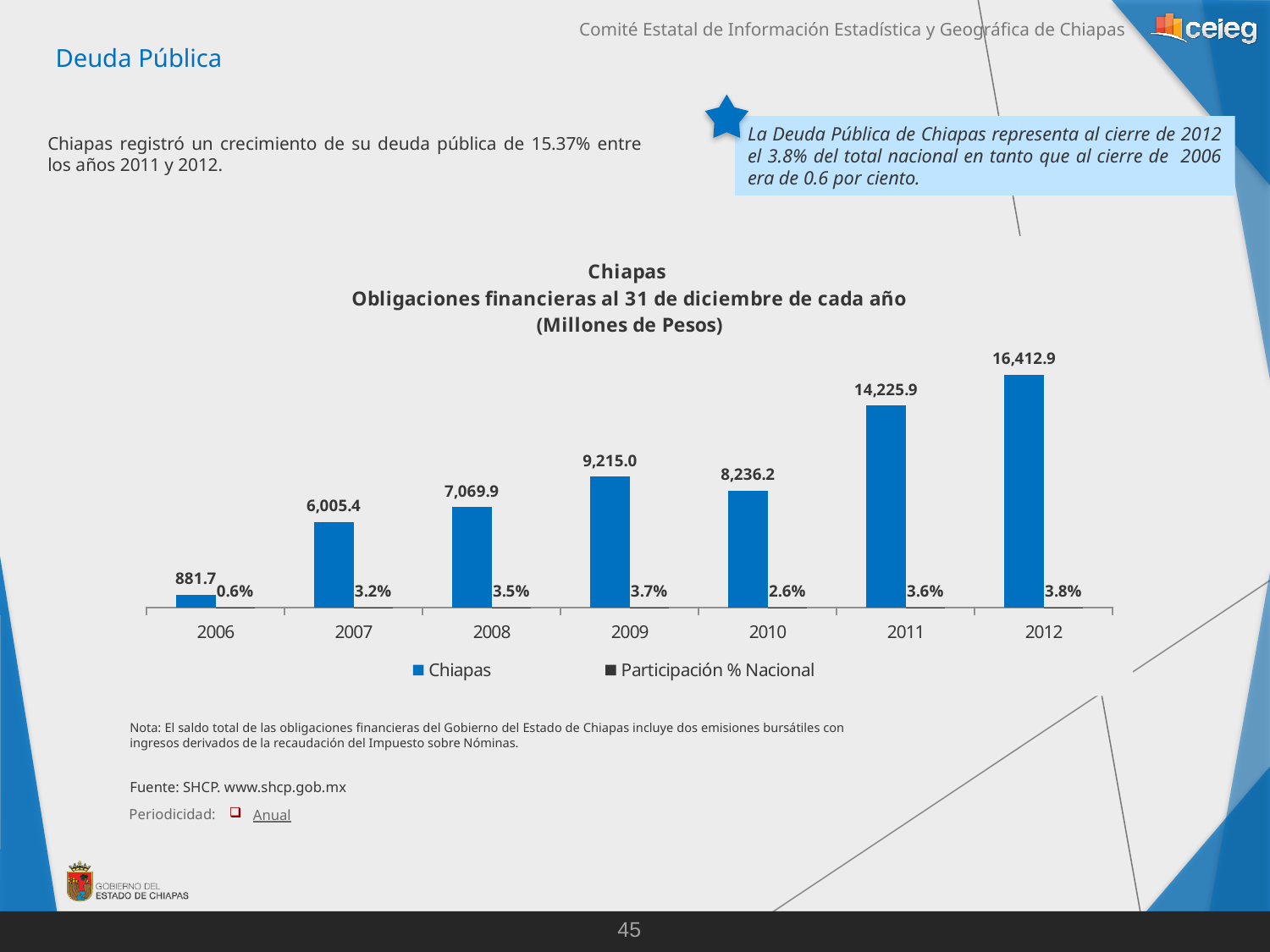
What unit is given in the chart title for the Chiapas values? Millones de Pesos Which year has the highest Chiapas value? 2012 What is the Chiapas value for 2012? 16,412.9 How many years are shown on the x axis? 7 What is the difference between the Chiapas values for 2012 and 2011? 2,187.0 What is the Participación % Nacional value for 2009? 3.7% Which year has the lowest Participación % Nacional value? 2006 What kind of chart is shown? Bar chart Which is larger, the Chiapas value for 2009 or for 2010? 2009 What is the Chiapas value for 2006? 881.7 What is the Participación % Nacional value for 2010? 2.6% How many series does the legend list? 2